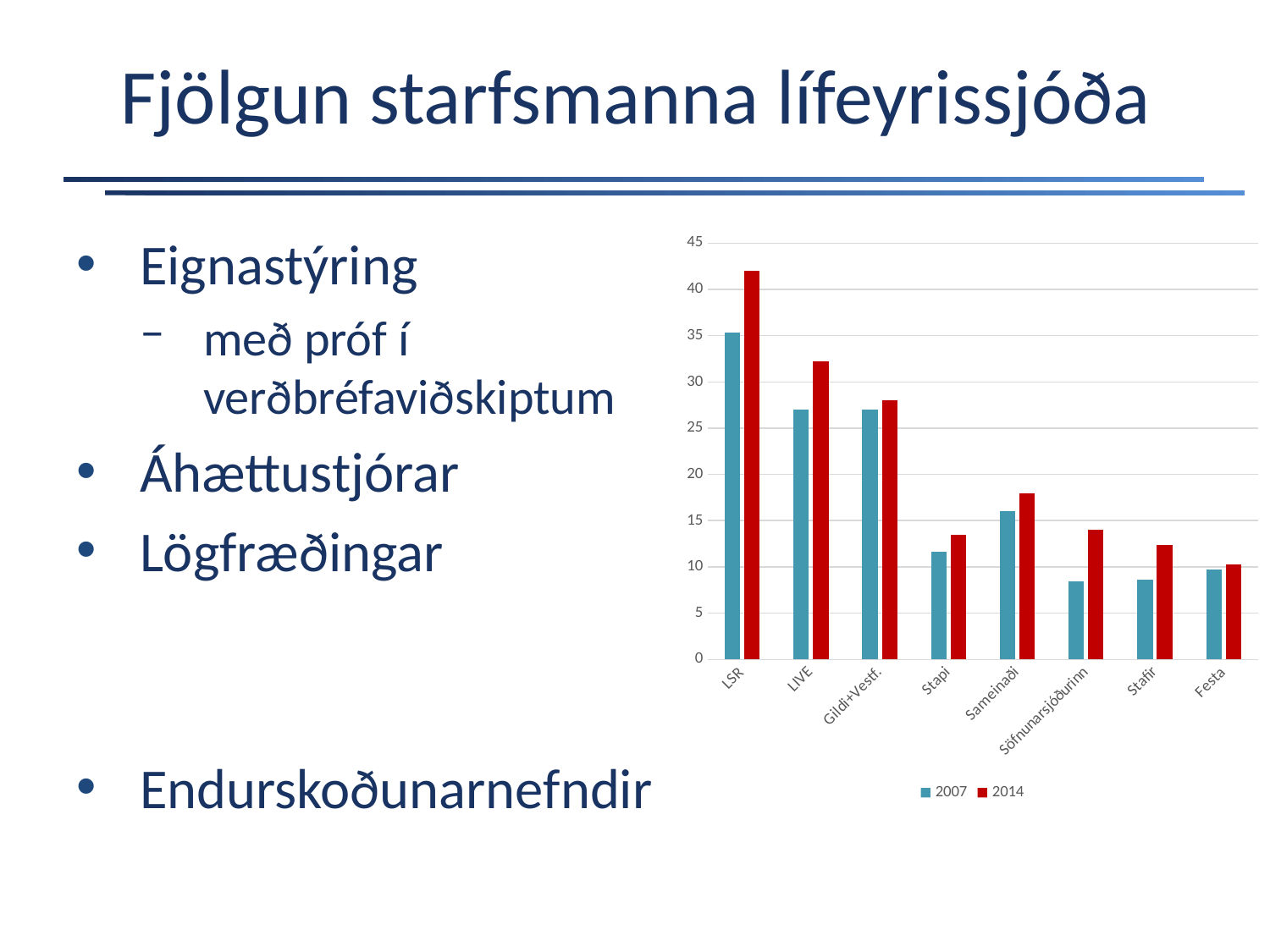
How many series does the chart's legend list? 2 Which category has the highest value for 2014? LSR Which years are listed in the chart's legend? 2007 and 2014 Is the 2007 value for Stapi greater or less than 15? less Which category has the lowest value for 2014? Festa For Söfnunarsjóðurinn, which is larger: the 2007 value or the 2014 value? 2014 Is the 2014 value for LIVE greater or less than 30? greater Which category has the highest value for 2007? LSR How many categories (pension funds) are shown on the x axis of the chart? 8 Which is larger: the 2014 value for Sameinaði or the 2014 value for Stapi? Sameinaði Is the 2014 value for LSR greater or less than 40? greater What kind of chart is shown on the slide? bar chart